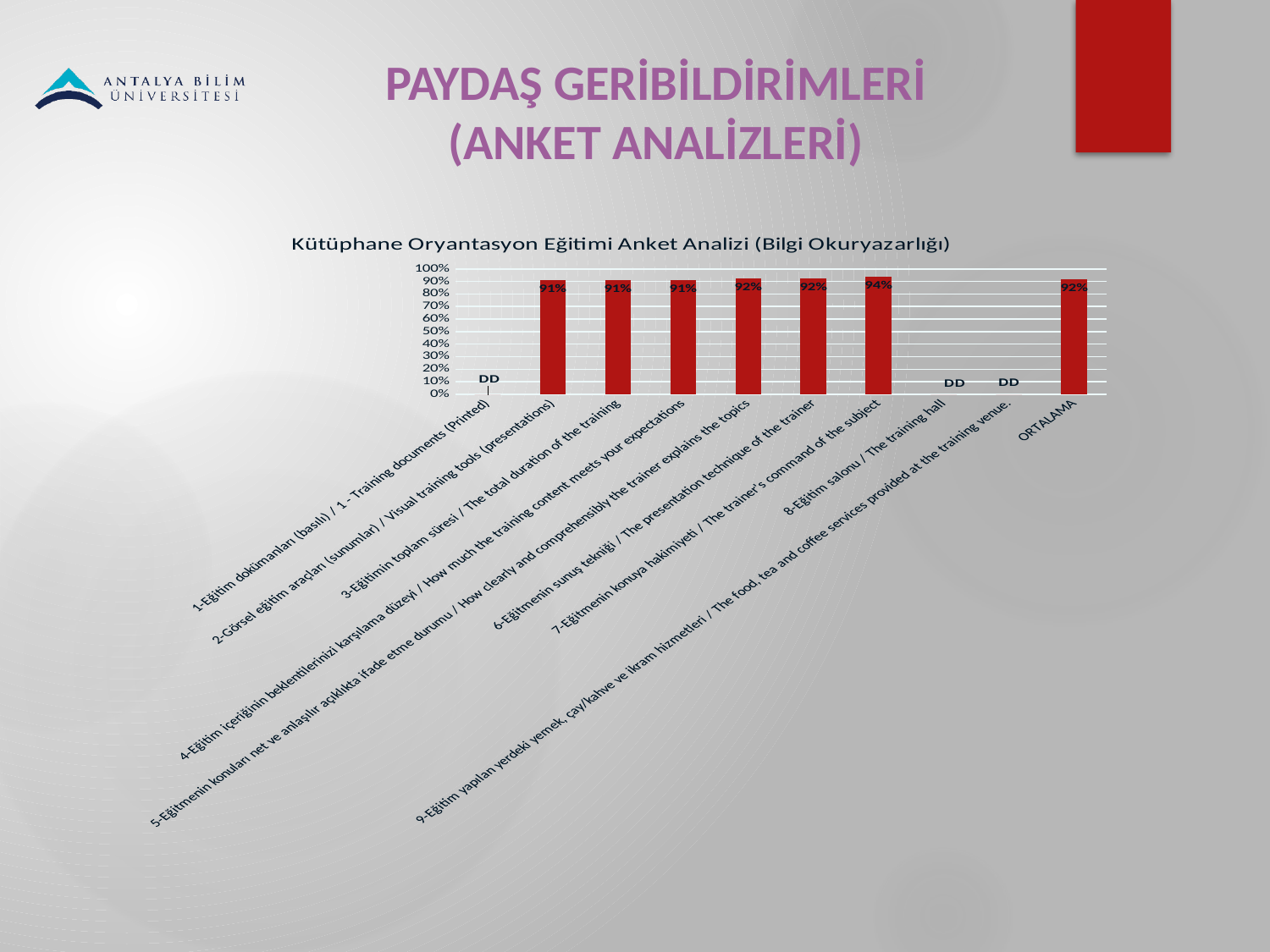
What type of chart is shown on the slide? bar chart Is the value for category 3 greater or less than 80%? greater What is the title of the chart? Kütüphane Oryantasyon Eğitimi Anket Analizi (Bilgi Okuryazarlığı) What is the value for ORTALAMA? 92% What is the difference between the value for category 7 and the value for category 3? 3% How many categories are shown on the x axis? 10 What is the value for category 5 (Eğitmenin konuları net ve anlaşılır açıklıkta ifade etme durumu)? 92% Which is larger, the value for category 6 or the value for category 4? category 6 What is the value for category 2 (Görsel eğitim araçları / Visual training tools)? 91% What label is shown instead of a bar for category 1, category 8 and category 9? DD Which category has the highest value among the bars shown? 7-Eğitmenin konuya hakimiyeti / The trainer's command of the subject What is the value for category 7 (Eğitmenin konuya hakimiyeti / The trainer's command of the subject)? 94%